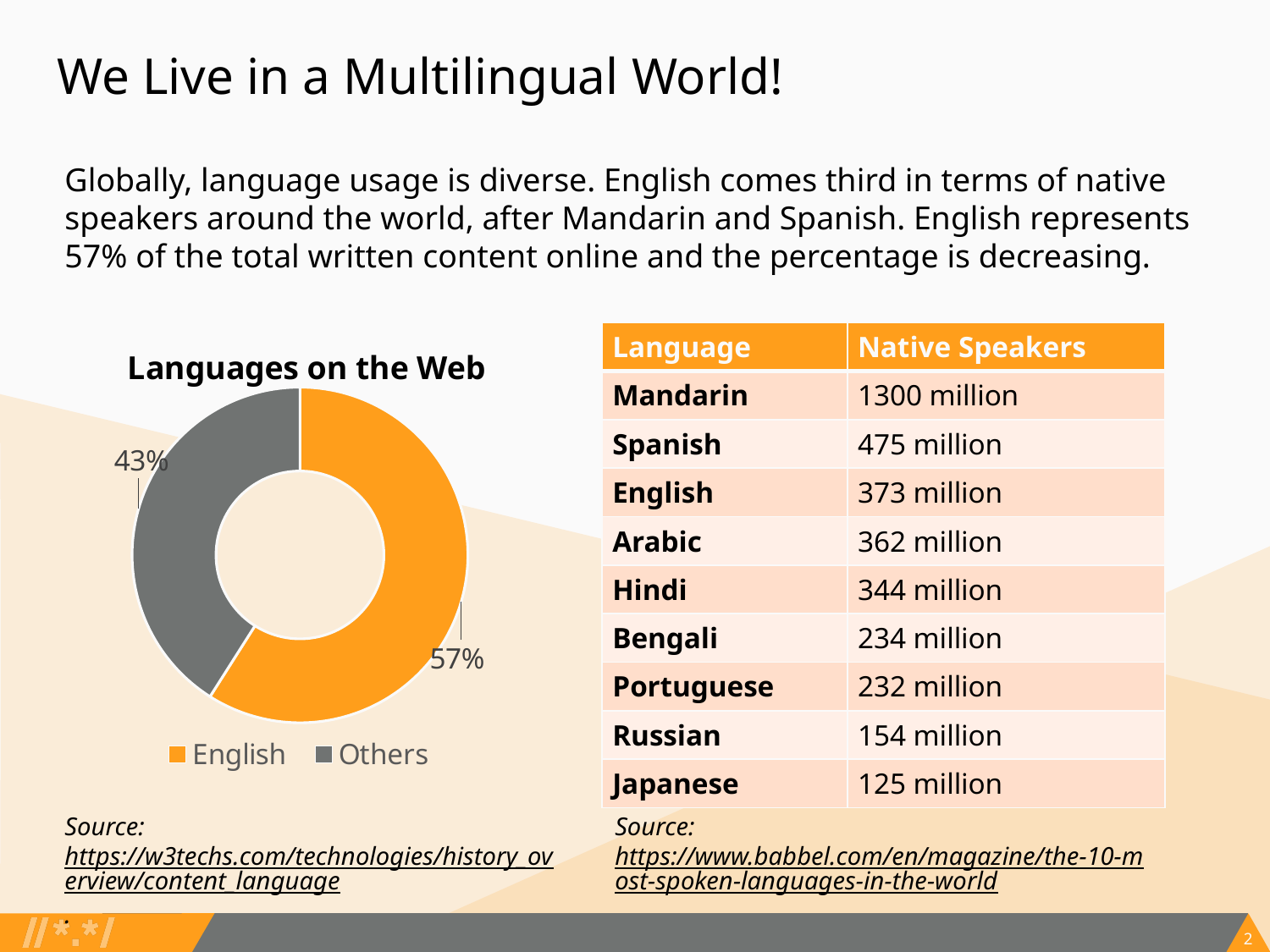
What is the title of the chart on the slide? Languages on the Web In the "Languages on the Web" chart, what share does Others have? 43% In the "Languages on the Web" chart, what colour is the English slice? orange Which slice is the largest in the "Languages on the Web" chart? English In the "Languages on the Web" chart, is the share for English greater or less than 50%? greater In the "Languages on the Web" chart, what share does English have? 57% In the "Languages on the Web" chart, what is the difference between the English share and the Others share? 14% In the "Languages on the Web" chart, which is larger, English or Others? English Which slice is the smallest in the "Languages on the Web" chart? Others What kind of chart is "Languages on the Web"? doughnut chart How many slices does the "Languages on the Web" chart have? 2 How many entries does the legend of the "Languages on the Web" chart list? 2